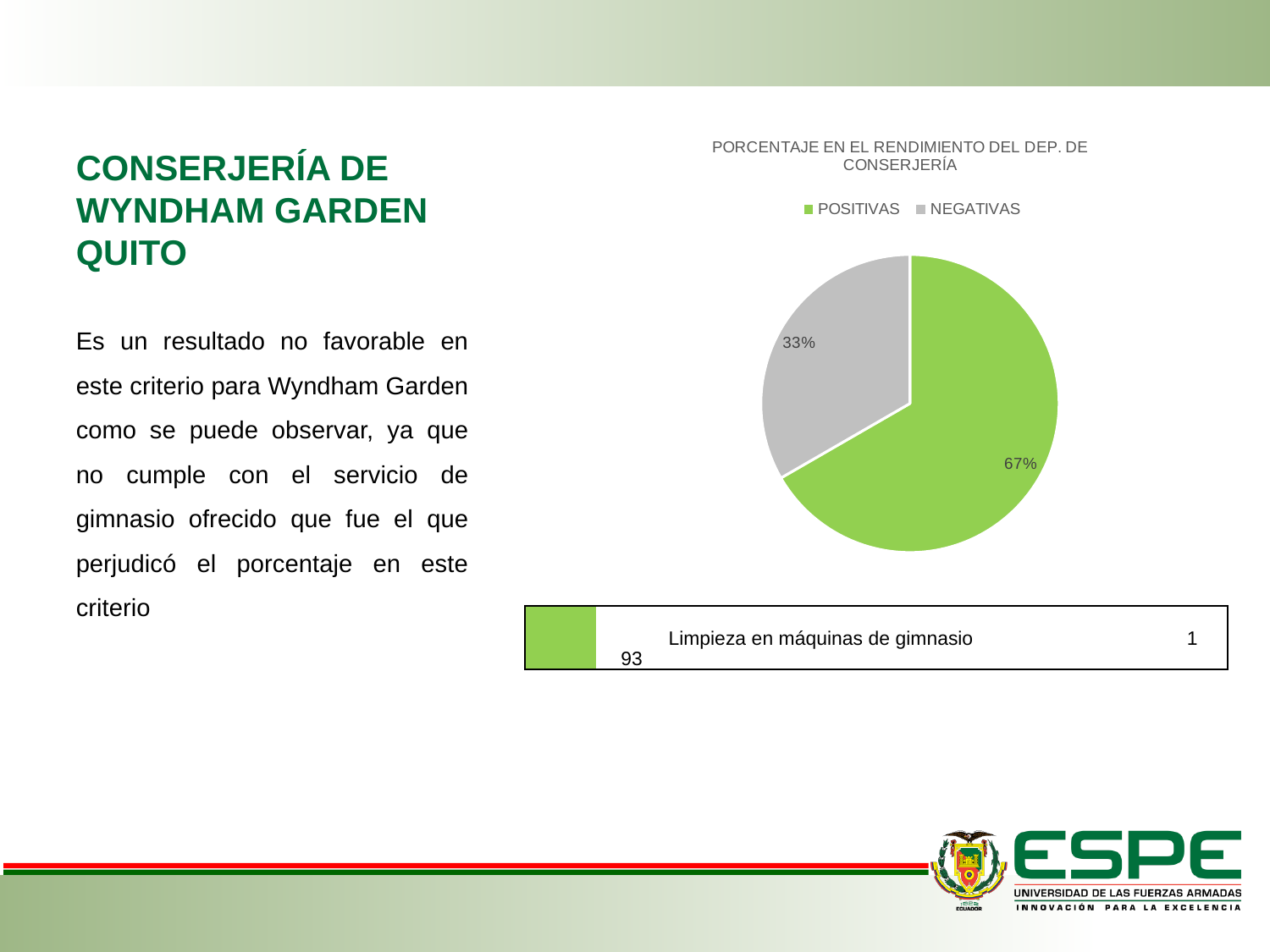
Which slice of the pie chart is the smallest? NEGATIVAS What percentage of the pie chart is labelled NEGATIVAS? 33% What is the difference in percentage points between the POSITIVAS and NEGATIVAS slices? 34 What type of chart is shown on the slide? Pie chart Which is larger in the pie chart, POSITIVAS or NEGATIVAS? POSITIVAS How many entries does the legend of the pie chart list? 2 What is the title of the chart on the slide? PORCENTAJE EN EL RENDIMIENTO DEL DEP. DE CONSERJERÍA What colour is the POSITIVAS slice in the pie chart? Green How many slices does the pie chart have? 2 What share of the pie does the NEGATIVAS slice represent? 33% What percentage of the pie chart is labelled POSITIVAS? 67% Which slice of the pie chart is the largest? POSITIVAS